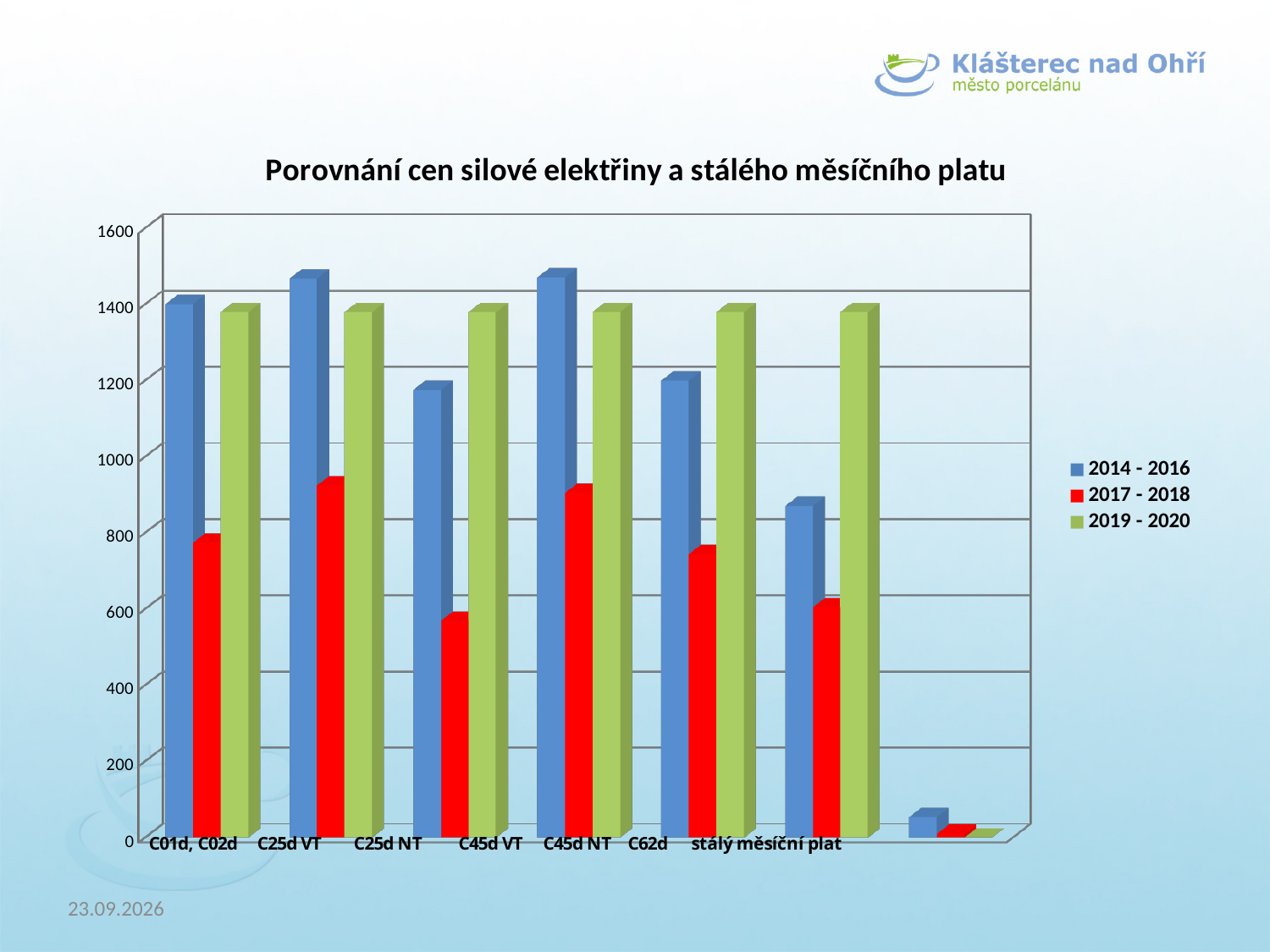
Is the value for C01d, C02d in the 2019 - 2020 series greater or less than 1200? greater Is the value for C25d NT in the 2017 - 2018 series greater or less than 800? less In the 2017 - 2018 series, which is larger: C25d VT or C25d NT? C25d VT How many series does the legend list? 3 Which category has the lowest value in the 2014 - 2016 series? stálý měsíční plat How many categories are shown on the x axis? 7 Is the value for C25d NT in the 2014 - 2016 series greater or less than 1000? greater In the 2014 - 2016 series, which is larger: C01d, C02d or C25d NT? C01d, C02d Which colour represents the 2017 - 2018 series? red What is the title of the chart? Porovnání cen silové elektřiny a stálého měsíčního platu What kind of chart is shown on the slide? bar chart